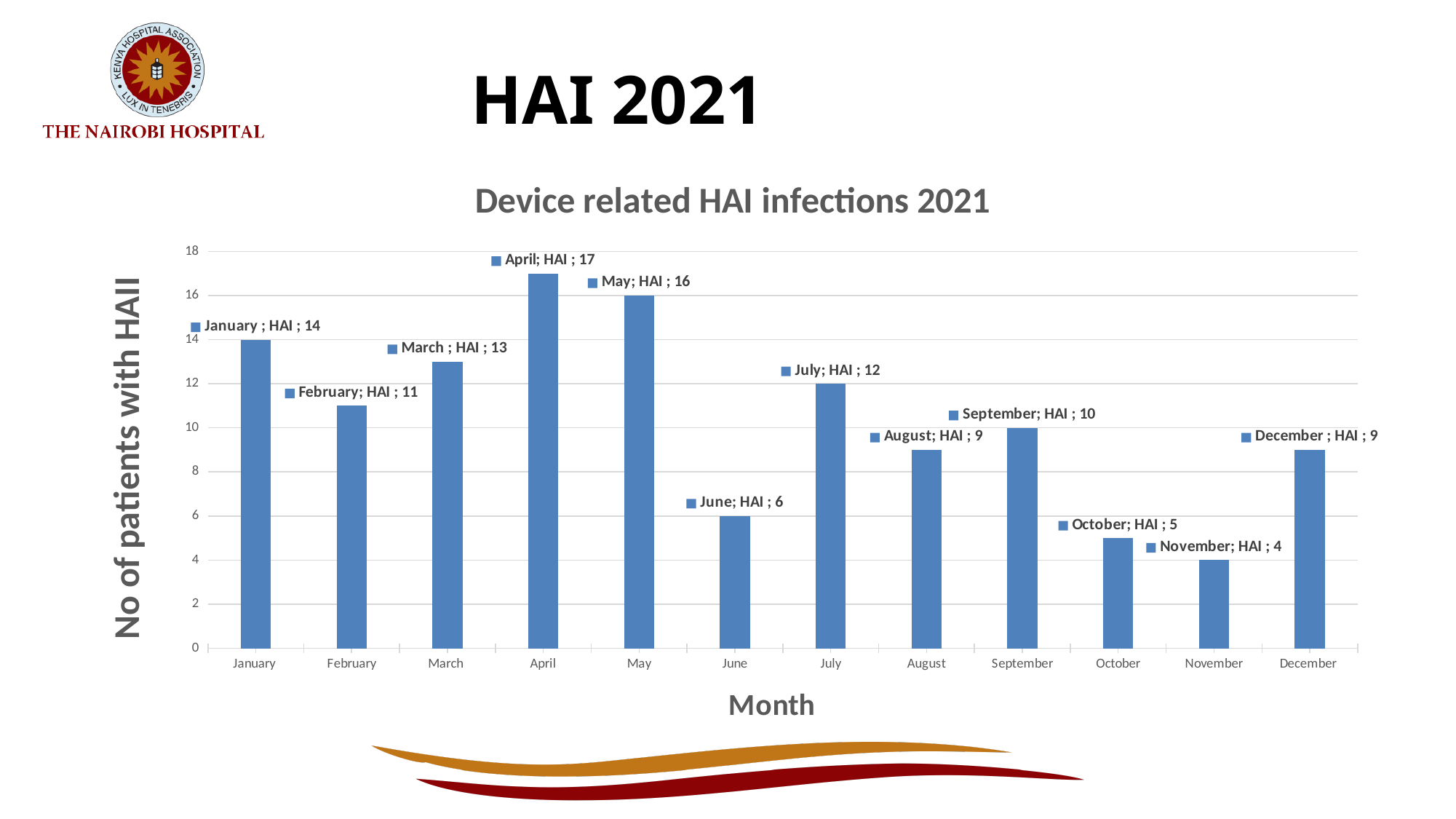
Which is larger, the value for May or the value for July? May Which month has the lowest number of patients with HAI? November What is the difference between the values for April and June? 11 What kind of chart is shown on the slide? Bar chart Which month has the highest number of patients with HAI? April What is the value for April? 17 How many months are shown on the x axis? 12 Is the value for March greater or less than 10? greater What is the title of the chart? Device related HAI infections 2021 What is the difference between the values for January and February? 3 What is the value for November? 4 What is the value for September? 10